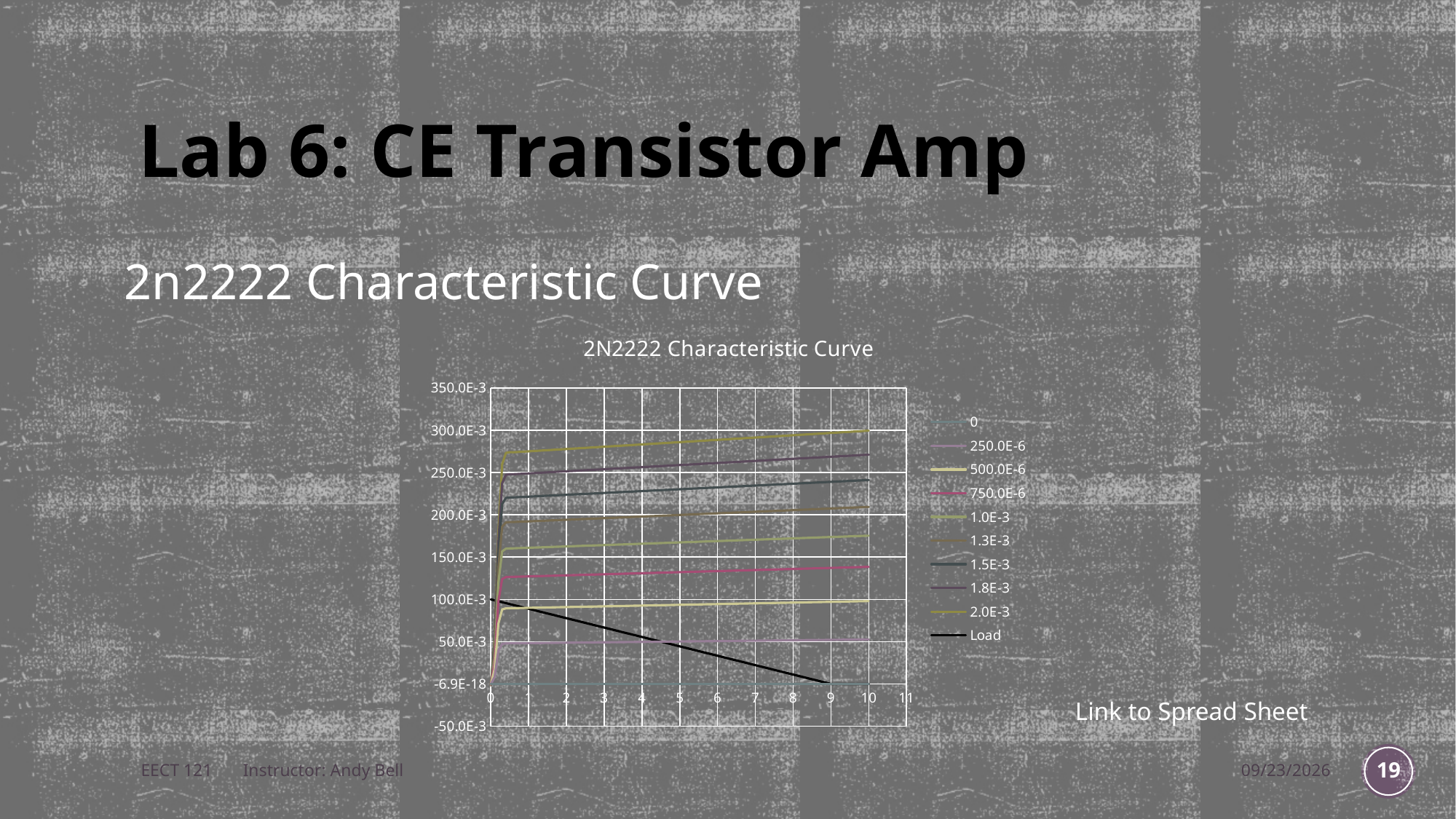
At x = 10, which series is larger, 1.8E-3 or 1.5E-3? 1.8E-3 How many series does the chart's legend list? 10 Is the value of the 1.0E-3 series at x = 10 greater or less than 200.0E-3? less Is the value of the 750.0E-6 series at x = 10 greater or less than 100.0E-3? greater What colour is the Load line in the chart? black What is the title of the chart? 2N2222 Characteristic Curve Does the Load line rise or fall as x increases? fall Which series has the highest value at x = 10? 2.0E-3 Is the value of the 1.5E-3 series at x = 10 greater or less than 250.0E-3? less What kind of chart is shown on the slide? line chart